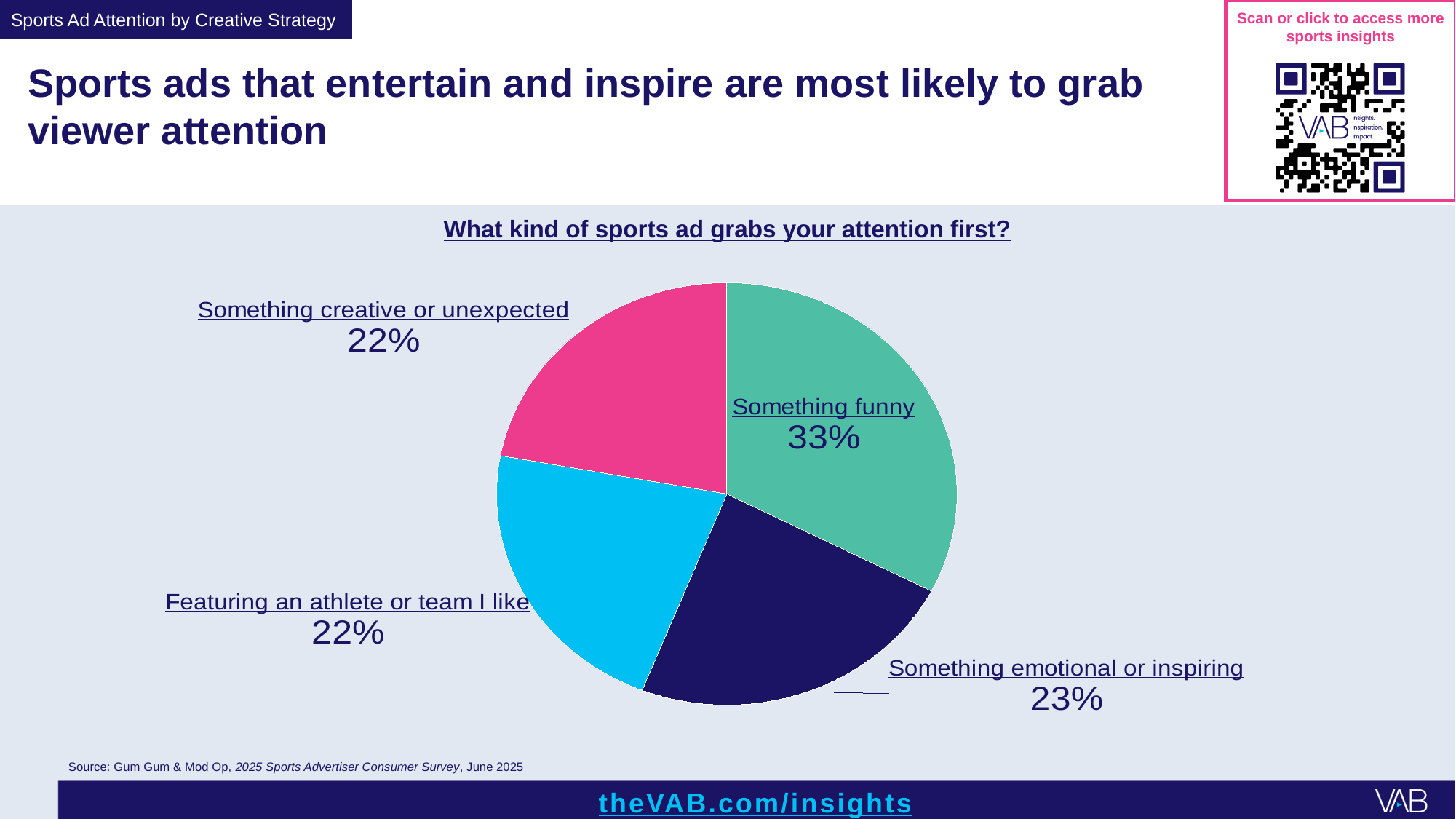
What share of respondents said 'Something creative or unexpected' grabs their attention first? 22% What is the difference in percentage points between 'Something funny' and 'Something emotional or inspiring'? 10 What colour is the 'Something funny' slice? green Which kind of sports ad has the largest share of the pie? Something funny What is the title of the chart? What kind of sports ad grabs your attention first? What share of respondents said 'Something emotional or inspiring' grabs their attention first? 23% What share of respondents said 'Something funny' grabs their attention first? 33% Which is larger: the share for 'Something funny' or the share for 'Something emotional or inspiring'? Something funny What is the difference in percentage points between 'Something funny' and 'Something creative or unexpected'? 11 What kind of chart is shown on the slide? pie chart What share of respondents said 'Featuring an athlete or team I like' grabs their attention first? 22% How many slices does the pie chart have? 4